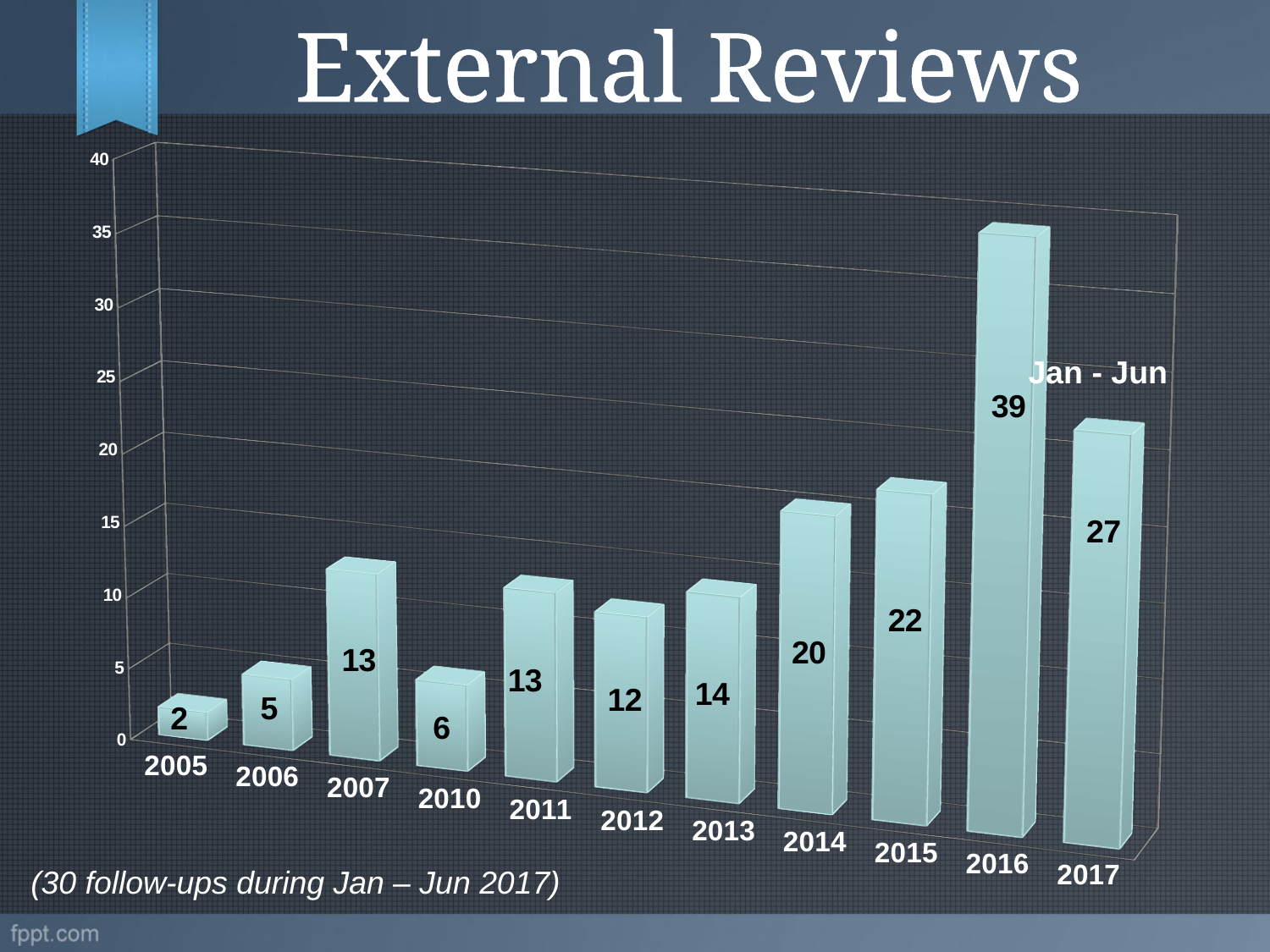
What kind of chart is shown on the slide? bar chart What is the value for 2017 (Jan - Jun)? 27 What is the value for 2014? 20 Which is larger, the value for 2013 or the value for 2012? 2013 What is the title of the slide? External Reviews What is the value for 2016? 39 Which year has the highest value? 2016 What is the value for 2005? 2 What is the difference between the values for 2015 and 2014? 2 What is the difference between the values for 2016 and 2017? 12 Which year has the lowest value? 2005 How many years are shown on the x axis? 11